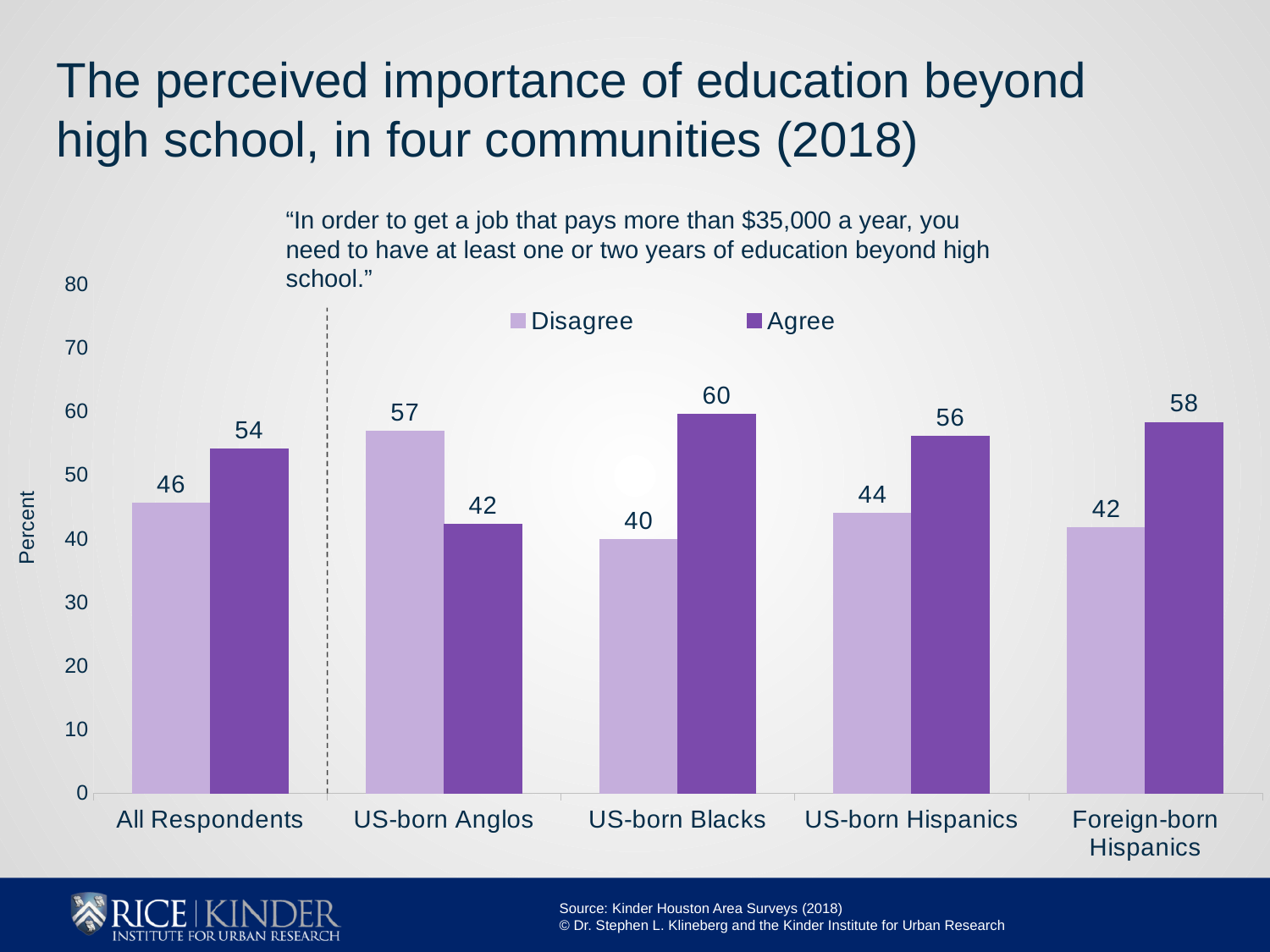
What is the Agree value for Foreign-born Hispanics? 58 What percentage of All Respondents agree with the statement? 54 Is the Agree value for US-born Hispanics greater or less than 50? greater What is the difference between the Agree and Disagree values for US-born Blacks? 20 For US-born Anglos, is the Agree value or the Disagree value larger? Disagree Which community has the lowest Disagree value? US-born Blacks What kind of chart is shown on the slide? Bar chart Which community has the highest Agree value? US-born Blacks How many categories are shown on the x axis? 5 What percentage of US-born Anglos disagree with the statement? 57 How many series does the legend list? 2 What is the label on the vertical axis? Percent